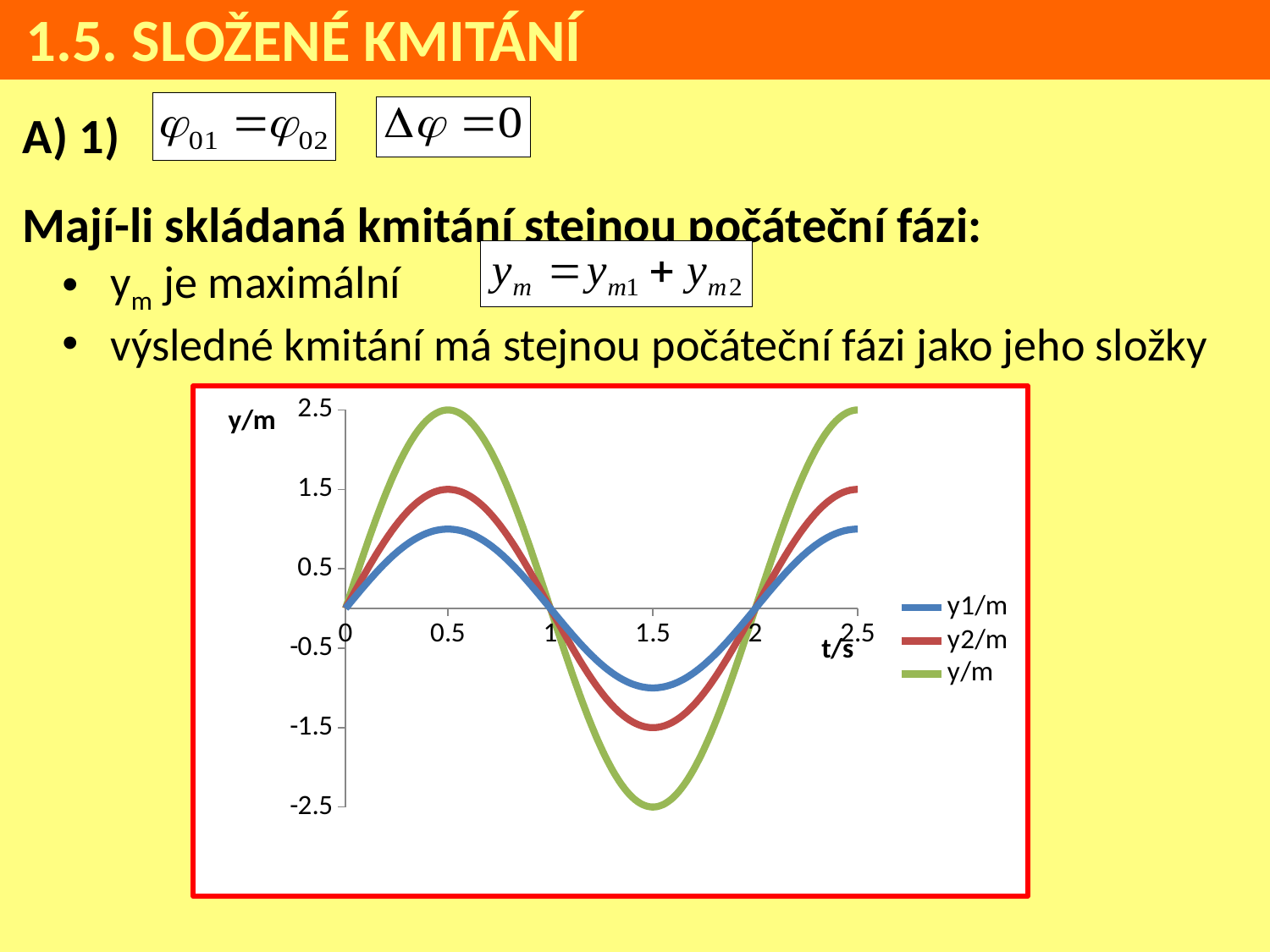
What is the maximum value reached by the y/m series? 2.5 Is the value of y1/m at t = 0.5 greater or less than 1.5? less At t = 0.5, which series has the larger value, y1/m or y2/m? y2/m What is the value of y/m at t = 1.5? -2.5 How many series does the chart legend list? 3 What is the label on the horizontal axis of the chart? t/s Which series reaches the highest value on the chart? y/m What is the value of y2/m at t = 0.5? 1.5 What is the minimum value reached by the y2/m series? -1.5 Which series reaches the lowest value on the chart? y/m What are the series names listed in the chart legend? y1/m, y2/m, y/m What kind of chart is shown on the slide? line chart